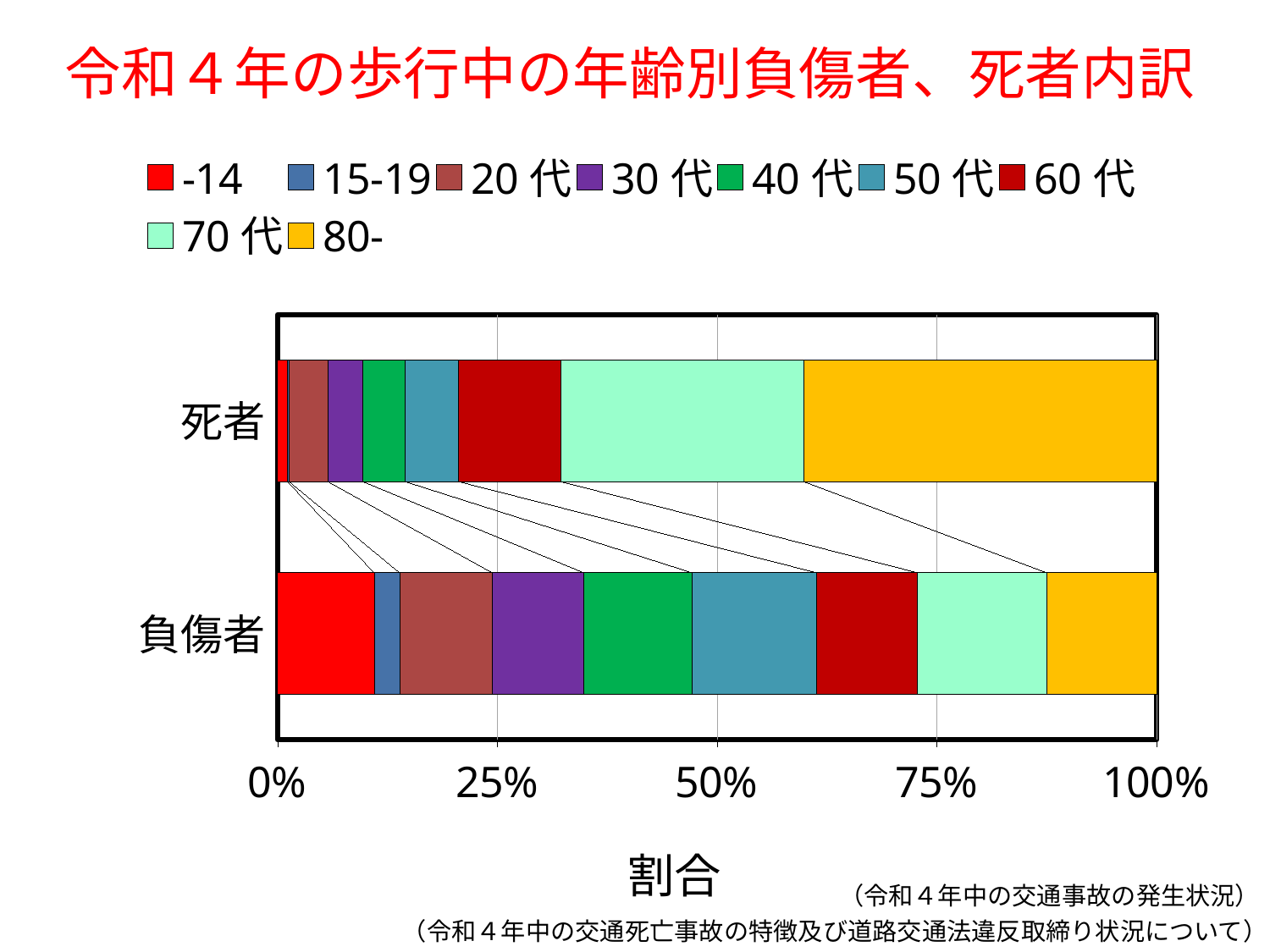
Is the share of 50 代 larger in the 死者 bar or in the 負傷者 bar? 負傷者 Is the share of 80- in the 死者 bar greater or less than 25%? greater Which age group has the smallest share in the 負傷者 bar? 15-19 Is the share of 80- larger in the 死者 bar or in the 負傷者 bar? 死者 What kind of chart is shown on the slide? Stacked bar chart How many categories (bars) does the chart show? 2 Which age group has the largest share in the 死者 bar? 80- How many series does the legend list? 9 What is the label of the horizontal axis? 割合 Is the share of -14 in the 負傷者 bar greater or less than 25%? less Which age group has the smallest share in the 死者 bar? 15-19 What is the title of the chart on the slide? 令和４年の歩行中の年齢別負傷者、死者内訳